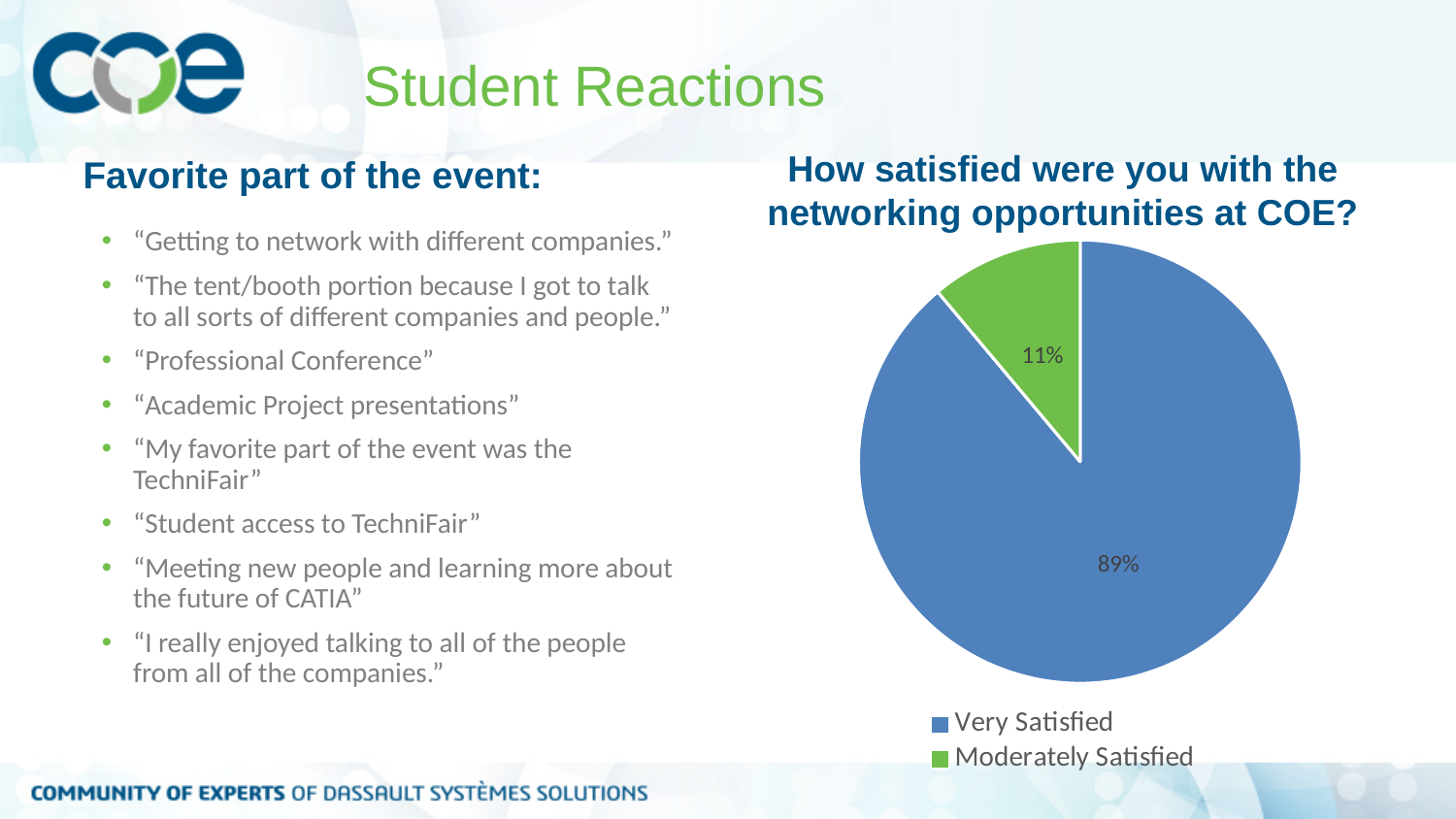
Which is larger, the Very Satisfied slice or the Moderately Satisfied slice? Very Satisfied What colour is the Moderately Satisfied slice? green Which category has the smallest slice of the pie? Moderately Satisfied What is the difference in percentage points between the Very Satisfied and Moderately Satisfied slices? 78 What is the title of the pie chart? How satisfied were you with the networking opportunities at COE? What share of the pie is labelled Moderately Satisfied? 11% How many slices does the pie chart have? 2 How many entries does the legend list? 2 What kind of chart is shown on the slide? pie chart Which category has the largest slice of the pie? Very Satisfied What share of the pie is labelled Very Satisfied? 89%